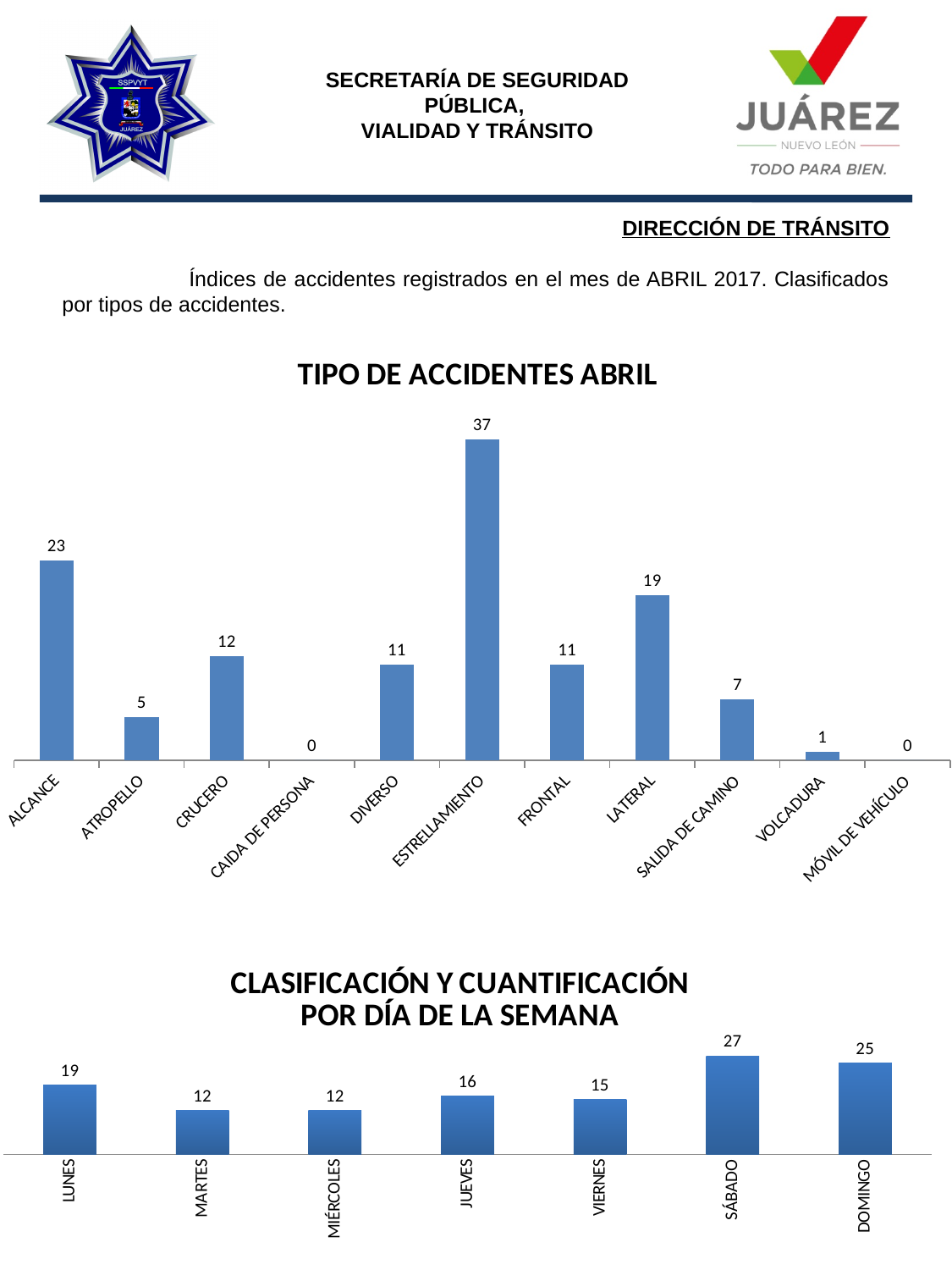
In the 'TIPO DE ACCIDENTES ABRIL' chart, which category has the highest value? ESTRELLAMIENTO How many categories are shown in the 'TIPO DE ACCIDENTES ABRIL' chart? 11 In the 'TIPO DE ACCIDENTES ABRIL' chart, what is the value for ESTRELLAMIENTO? 37 In the 'TIPO DE ACCIDENTES ABRIL' chart, which is larger, CRUCERO or ATROPELLO? CRUCERO In the 'CLASIFICACIÓN Y CUANTIFICACIÓN POR DÍA DE LA SEMANA' chart, what is the difference between DOMINGO and LUNES? 6 What type of chart is 'TIPO DE ACCIDENTES ABRIL'? Bar chart In the 'CLASIFICACIÓN Y CUANTIFICACIÓN POR DÍA DE LA SEMANA' chart, which day has the highest value? SÁBADO In the 'TIPO DE ACCIDENTES ABRIL' chart, what is the difference between ALCANCE and LATERAL? 4 In the 'TIPO DE ACCIDENTES ABRIL' chart, what is the value for SALIDA DE CAMINO? 7 In the 'CLASIFICACIÓN Y CUANTIFICACIÓN POR DÍA DE LA SEMANA' chart, what is the value for SÁBADO? 27 In the 'CLASIFICACIÓN Y CUANTIFICACIÓN POR DÍA DE LA SEMANA' chart, which is larger, JUEVES or VIERNES? JUEVES How many days are shown in the 'CLASIFICACIÓN Y CUANTIFICACIÓN POR DÍA DE LA SEMANA' chart? 7